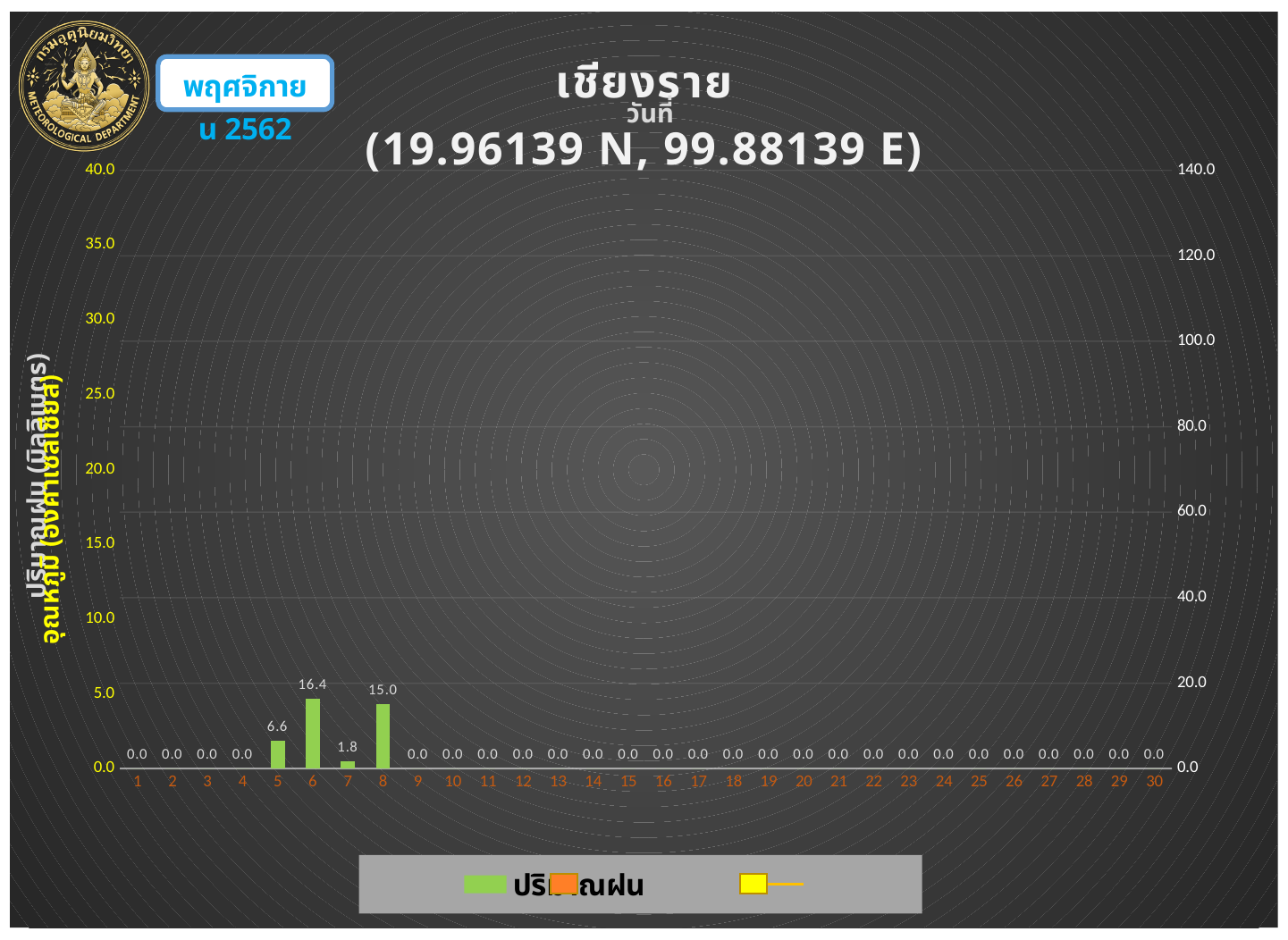
Which is larger, the rainfall value for day 6 or for day 8? day 6 How many days are shown on the x axis? 30 What is the difference between the rainfall values for day 6 and day 8? 1.4 What kind of chart is shown on the slide? bar chart What is the difference between the rainfall values for day 5 and day 7? 4.8 What is the rainfall value shown for day 5? 6.6 Which day has the highest rainfall value? 6 How many days have a rainfall value greater than 0.0? 4 What is the rainfall value shown for day 6? 16.4 What is the rainfall value shown for day 12? 0.0 What is the rainfall value shown for day 8? 15.0 What is the rainfall value shown for day 7? 1.8